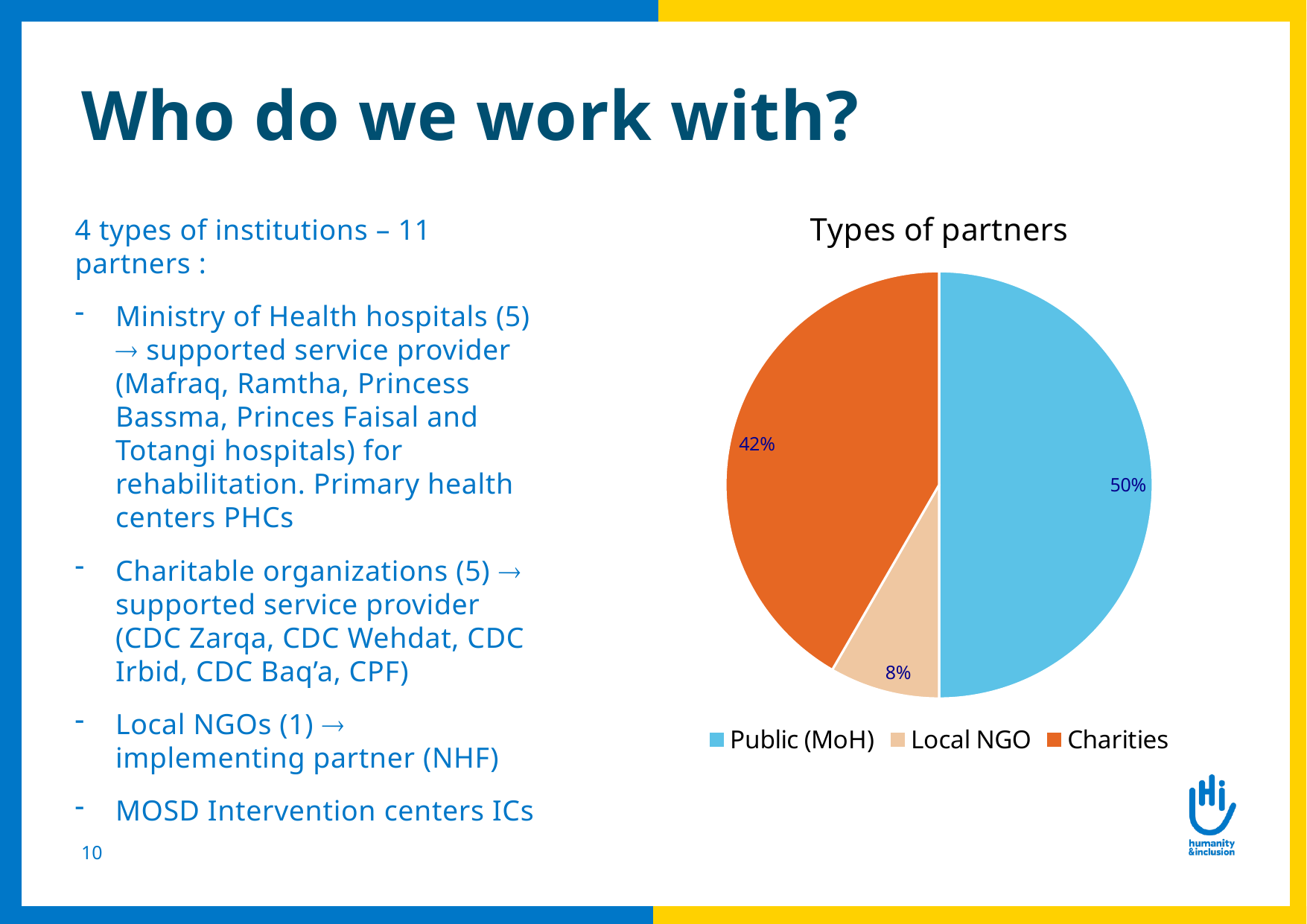
Which is larger, the share for Charities or the share for Local NGO? Charities What type of chart is shown on the slide? pie chart Which colour represents Charities in the legend? orange What share of the pie does Charities represent? 42% What is the difference in percentage points between Public (MoH) and Charities? 8 What is the difference in percentage points between Charities and Local NGO? 34 What is the title of the chart? Types of partners What share of the pie does Local NGO represent? 8% What share of the pie does Public (MoH) represent? 50% Which category has the largest slice of the pie? Public (MoH) How many categories does the pie chart show? 3 Which category has the smallest slice of the pie? Local NGO